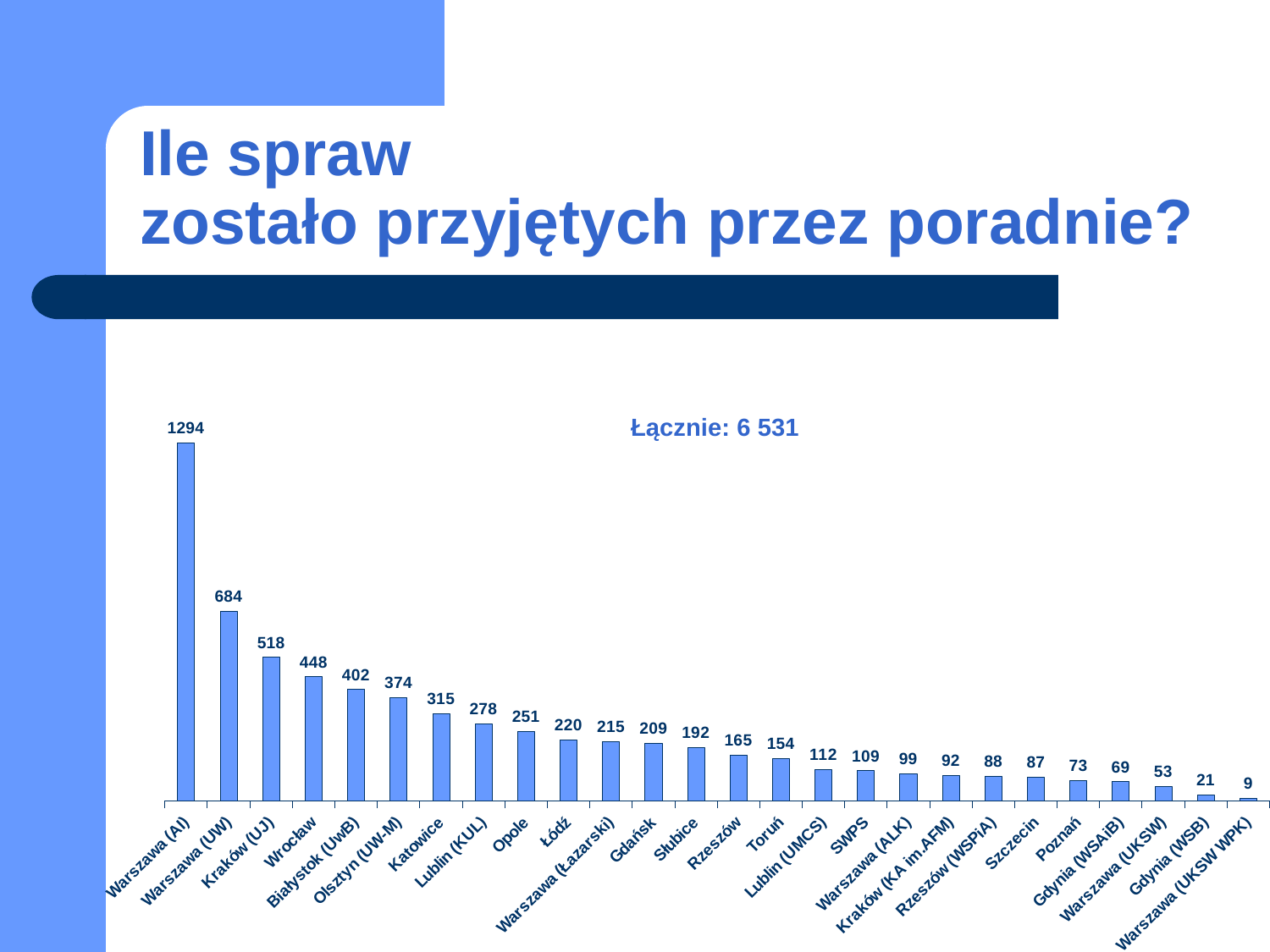
Which is larger, the value for Opole or the value for Gdańsk? Opole What is the value for Katowice? 315 What is the difference between the values for Warszawa (AI) and Warszawa (UW)? 610 What is the value for Gdynia (WSB)? 21 What is the value for Lublin (UMCS)? 112 What total is stated in the text label on the chart? Łącznie: 6 531 Which category has the highest value? Warszawa (AI) Which category has the lowest value? Warszawa (UKSW WPK) What kind of chart is shown on the slide? Bar chart What is the difference between the values for Kraków (UJ) and Wrocław? 70 What is the value for Warszawa (UW)? 684 How many categories are shown on the chart? 26